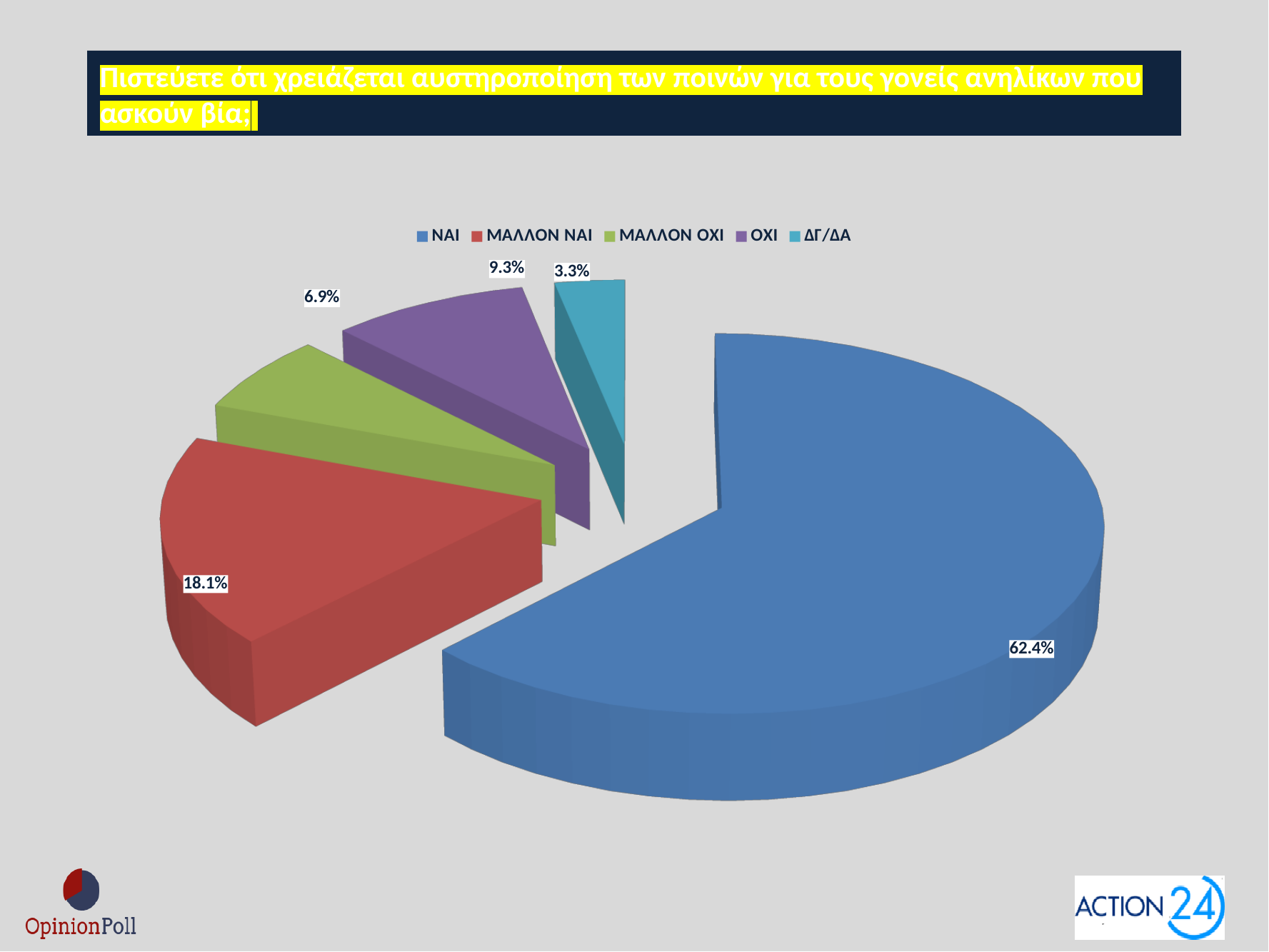
What colour is the ΝΑΙ slice? Blue What is the value for ΜΑΛΛΟΝ ΟΧΙ? 6.9% What is the value for ΔΓ/ΔΑ? 3.3% What is the difference between the ΝΑΙ and ΜΑΛΛΟΝ ΝΑΙ shares? 44.3% What is the value for ΟΧΙ? 9.3% Which category has the largest share of the pie? ΝΑΙ What is the value for ΜΑΛΛΟΝ ΝΑΙ? 18.1% Which category has the smallest share of the pie? ΔΓ/ΔΑ What type of chart is shown on the slide? Pie chart Which is larger, the share for ΟΧΙ or the share for ΜΑΛΛΟΝ ΟΧΙ? ΟΧΙ How many categories does the pie chart have? 5 What percentage of respondents answered ΝΑΙ? 62.4%